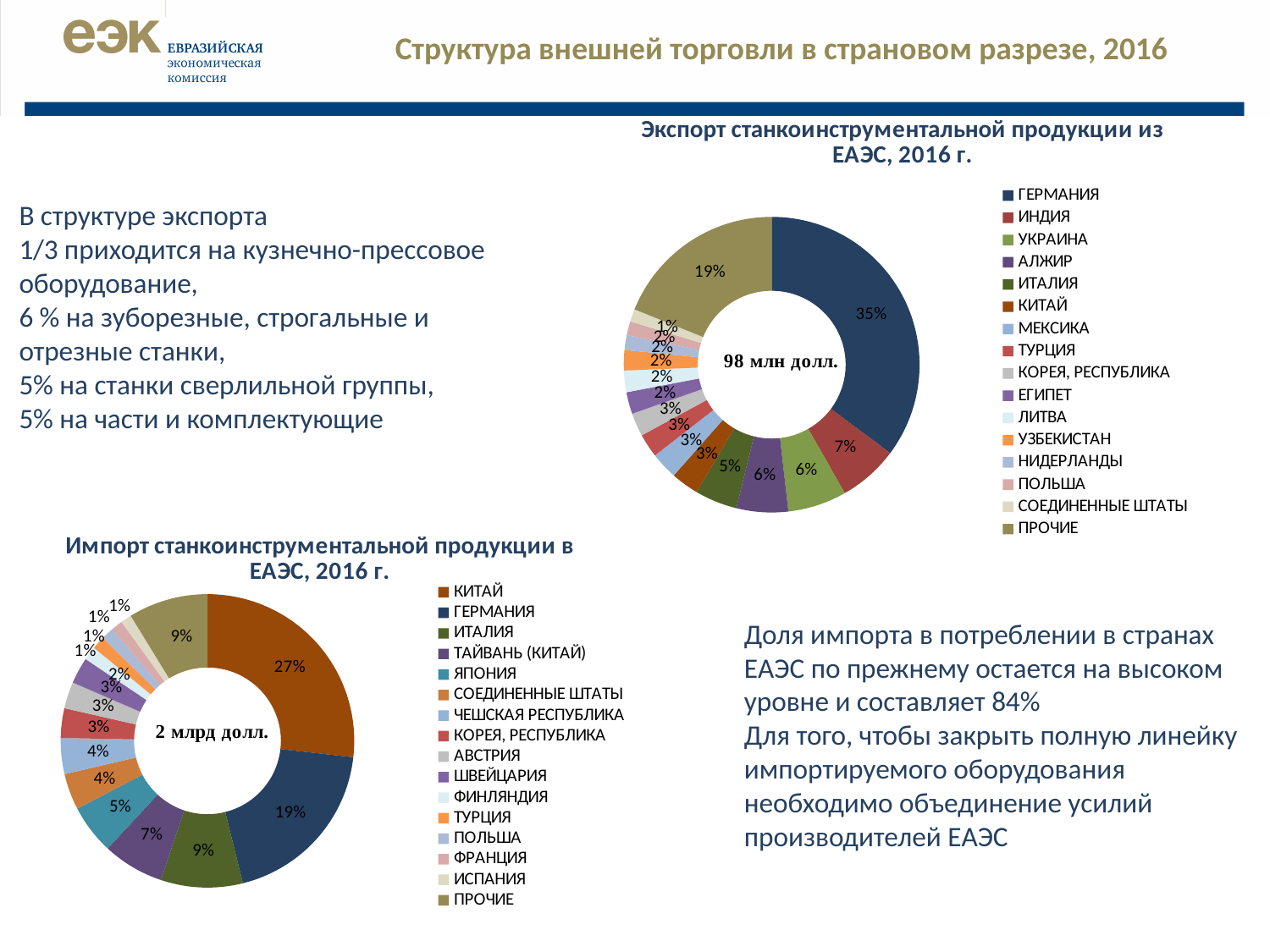
In the chart 'Импорт станкоинструментальной продукции в ЕАЭС, 2016 г.', what share does ГЕРМАНИЯ have? 19% What type of chart is used for 'Импорт станкоинструментальной продукции в ЕАЭС, 2016 г.'? Doughnut (pie) chart In the chart 'Импорт станкоинструментальной продукции в ЕАЭС, 2016 г.', what total value is shown in the centre of the doughnut? 2 млрд долл. In the chart 'Экспорт станкоинструментальной продукции из ЕАЭС, 2016 г.', what share does ИНДИЯ have? 7% In the chart 'Экспорт станкоинструментальной продукции из ЕАЭС, 2016 г.', what share does ГЕРМАНИЯ have? 35% In the chart 'Экспорт станкоинструментальной продукции из ЕАЭС, 2016 г.', what is the difference between the shares of ГЕРМАНИЯ and ПРОЧИЕ? 16 percentage points In the chart 'Импорт станкоинструментальной продукции в ЕАЭС, 2016 г.', what share does КИТАЙ have? 27% In the chart 'Импорт станкоинструментальной продукции в ЕАЭС, 2016 г.', which country has the largest share? КИТАЙ In the chart 'Экспорт станкоинструментальной продукции из ЕАЭС, 2016 г.', which country has the largest share? ГЕРМАНИЯ In the chart 'Экспорт станкоинструментальной продукции из ЕАЭС, 2016 г.', how many entries does the legend list? 16 In the chart 'Экспорт станкоинструментальной продукции из ЕАЭС, 2016 г.', what total value is shown in the centre of the doughnut? 98 млн долл. In the chart 'Импорт станкоинструментальной продукции в ЕАЭС, 2016 г.', which is larger, the share of ИТАЛИЯ or the share of ТАЙВАНЬ (КИТАЙ)? ИТАЛИЯ